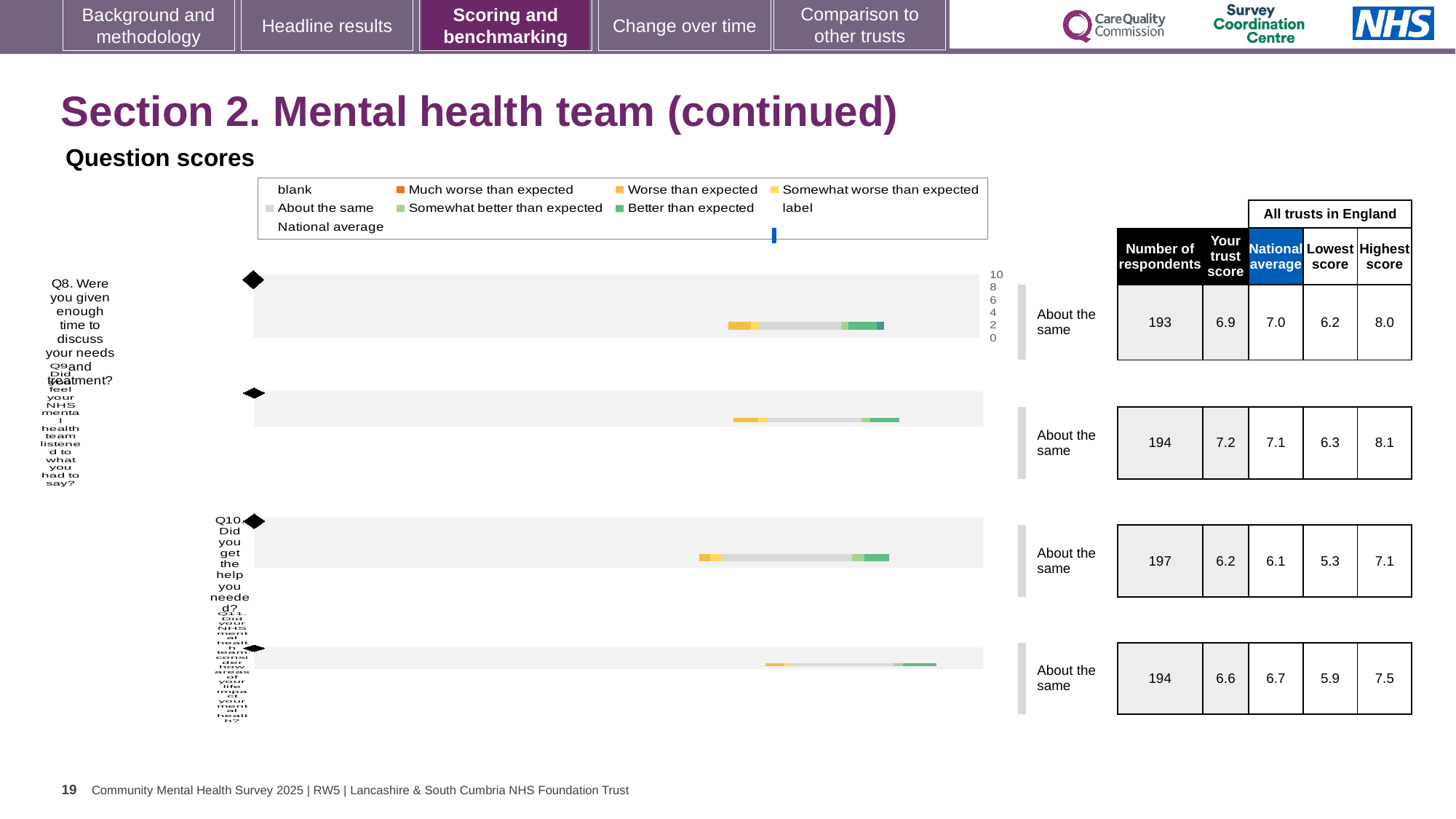
Which question (Q8 to Q11) has the highest 'Your trust score'? Q9 Which question (Q8 to Q11) has the lowest 'Your trust score'? Q10 What kind of chart is used to show the Q8 question score? bar chart In the chart legend, what colour represents 'Much worse than expected'? orange For the Q11 chart, what is the highest score among all trusts in England? 7.5 For the Q10 chart, what is the national average score? 6.1 For the Q8 chart, what is the number of respondents shown in the table? 193 How many question charts (Q8 to Q11) are shown on the slide? 4 For the Q8 chart, what is the difference between the highest score (8.0) and the lowest score (6.2) among all trusts in England? 1.8 In the chart legend, what colour represents 'Better than expected'? green For the Q9 chart, what is 'Your trust score'? 7.2 For the Q11 chart, which is larger: 'Your trust score' or the national average? National average